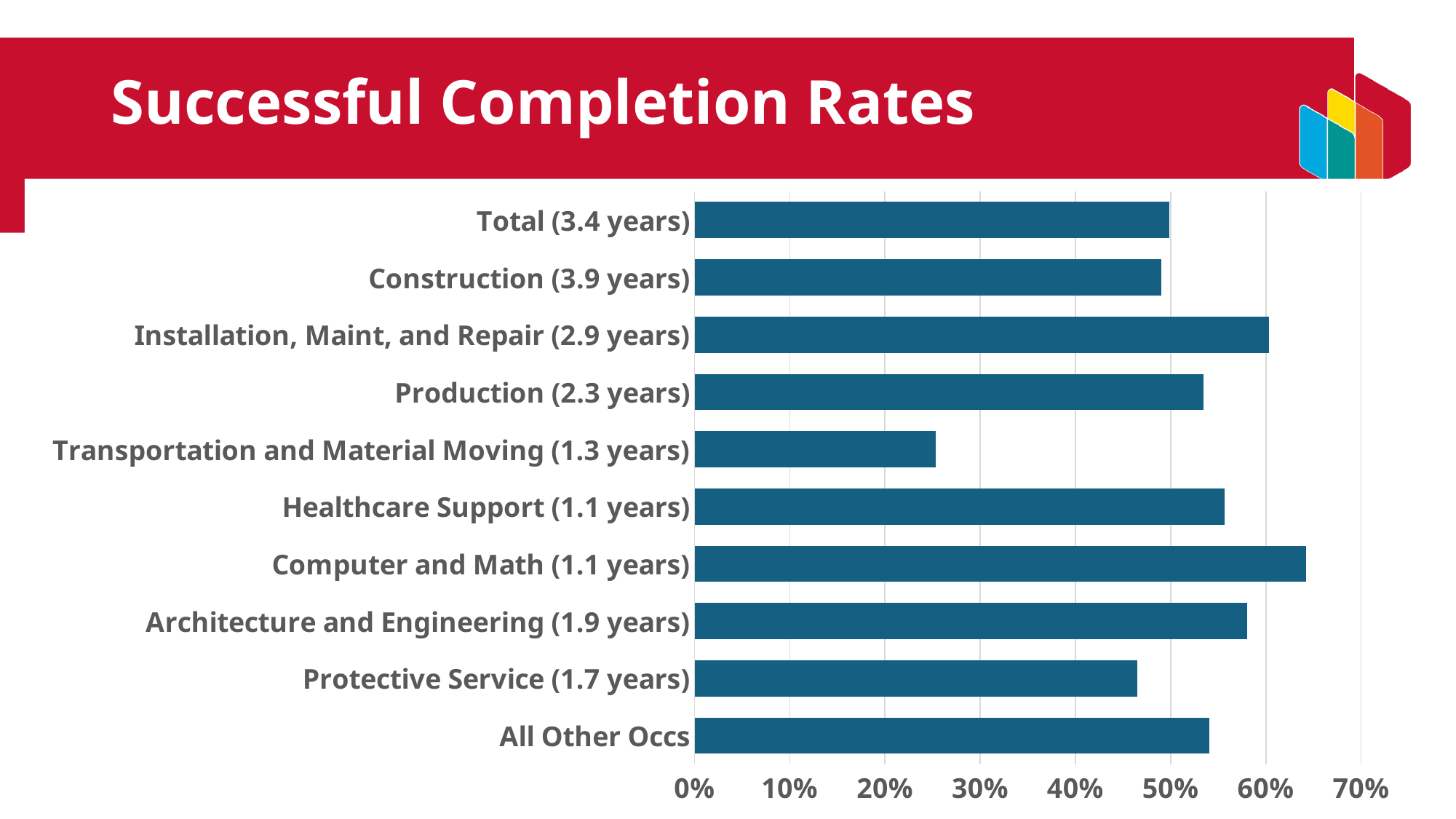
Is the value for Protective Service (1.7 years) greater or less than 50%? less Is the value for Computer and Math (1.1 years) greater or less than 60%? greater Is the value for Transportation and Material Moving (1.3 years) greater or less than 30%? less What is the highest value shown on the horizontal axis? 70% What kind of chart is shown on the slide? bar chart Which is larger, the value for Healthcare Support (1.1 years) or the value for Transportation and Material Moving (1.3 years)? Healthcare Support (1.1 years) How many categories (bars) are plotted in the chart? 10 What is the title of the slide? Successful Completion Rates Which is larger, the value for Installation, Maint, and Repair (2.9 years) or the value for Construction (3.9 years)? Installation, Maint, and Repair (2.9 years) Which category has the highest successful completion rate? Computer and Math (1.1 years) Which category has the lowest successful completion rate? Transportation and Material Moving (1.3 years)